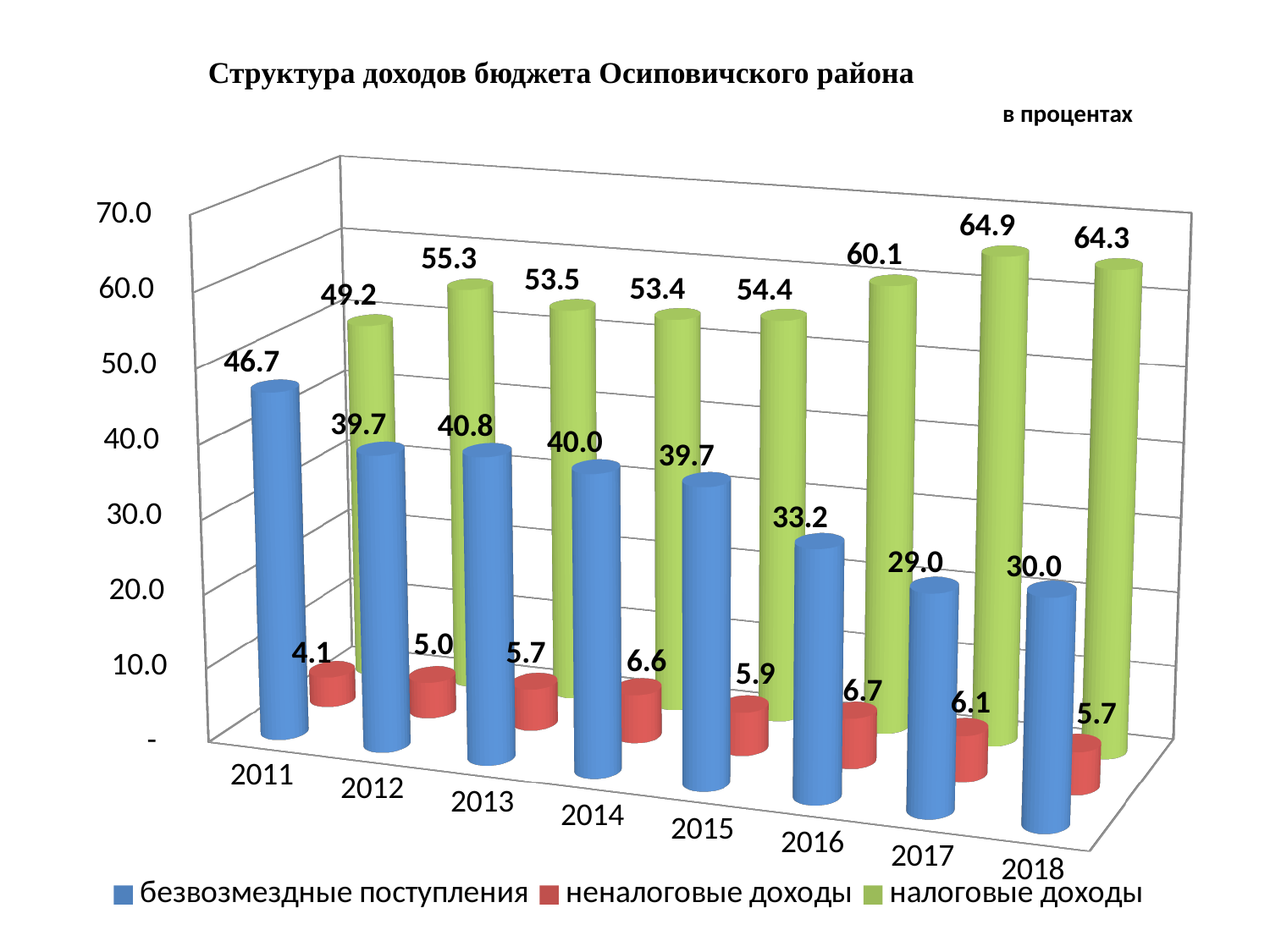
How many series does the legend list? 3 What kind of chart is shown on the slide? bar chart What is the value for неналоговые доходы in 2014? 6.6 Does безвозмездные поступления generally rise or fall from 2011 to 2018? fall Which is larger in 2016: безвозмездные поступления or налоговые доходы? налоговые доходы In which year is неналоговые доходы lowest? 2011 How many years are shown on the x axis? 8 In which year is налоговые доходы highest? 2017 What is the value for налоговые доходы in 2017? 64.9 What is the value for безвозмездные поступления in 2011? 46.7 What is the difference between налоговые доходы in 2018 and in 2011? 15.1 In which year is безвозмездные поступления lowest? 2017